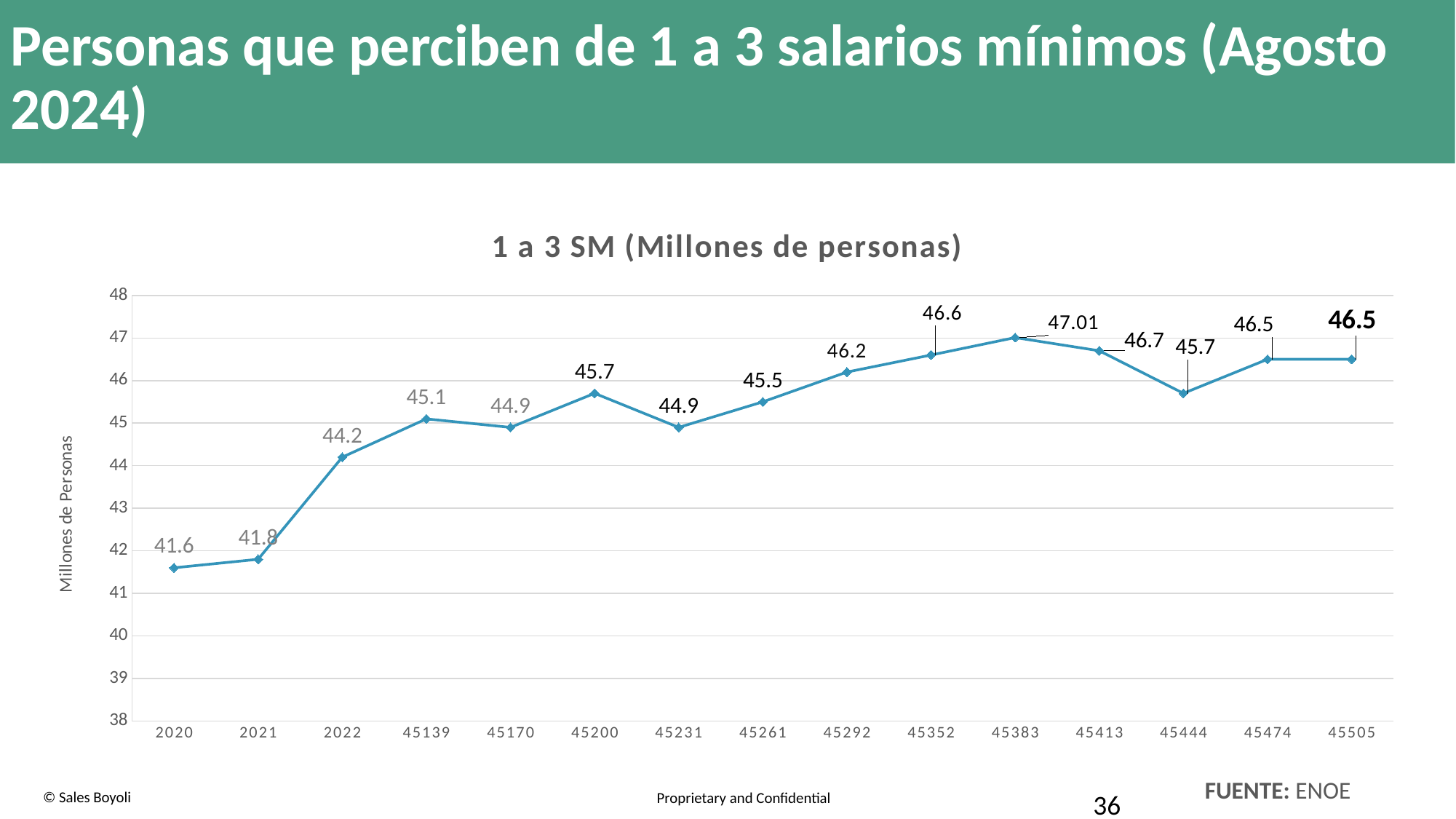
What is the title of the chart? 1 a 3 SM (Millones de personas) What is the value for 2020? 41.6 Which category has the highest value? 45383 What kind of chart is shown on the slide? Line chart What is the difference between the values for 2022 and 2021? 2.4 How many data points are plotted on the chart? 15 What is the value for the category labelled 45505? 46.5 What is the value for the category labelled 45383? 47.01 Is the value for 2021 greater or less than 42? less Which category has the lowest value? 2020 What is the value for 2022? 44.2 Which is larger, the value for 45352 or the value for 45444? 45352